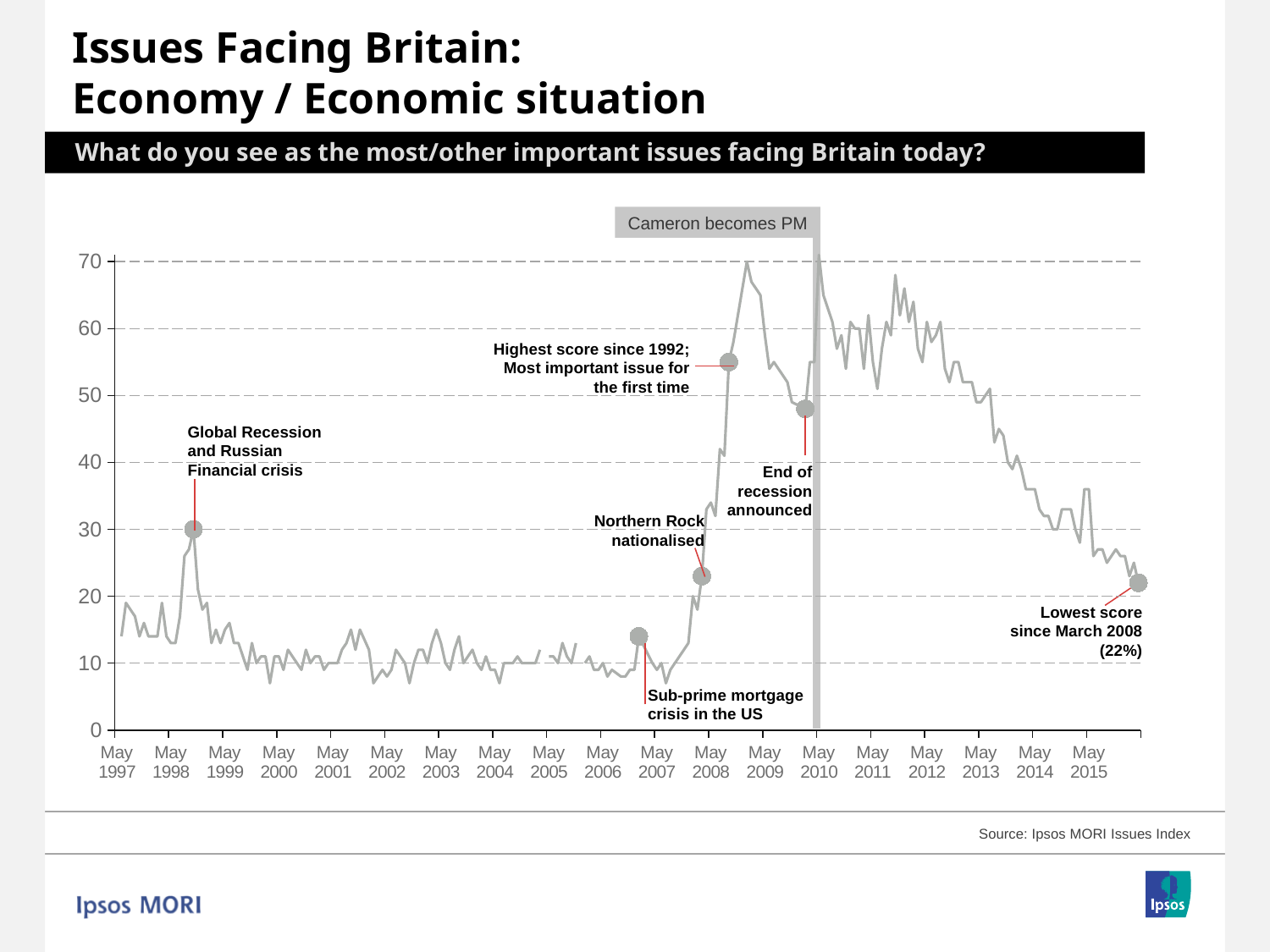
Does the line rise or fall between May 2007 and May 2009? rise Is the value at the point labelled 'Sub-prime mortgage crisis in the US' greater or less than 20? less Is the peak of the line around 2009 greater or less than 60? greater Does the line generally rise or fall between May 2012 and May 2015? fall How many year labels are shown on the x axis? 19 What type of chart is shown on the slide? line chart What value is given for the lowest score since March 2008? 22% Is the value at the point labelled 'Global Recession and Russian Financial crisis' greater or less than 20? greater What event does the vertical grey bar on the chart mark? Cameron becomes PM Which annotated point is higher: 'Highest score since 1992' or 'Northern Rock nationalised'? Highest score since 1992